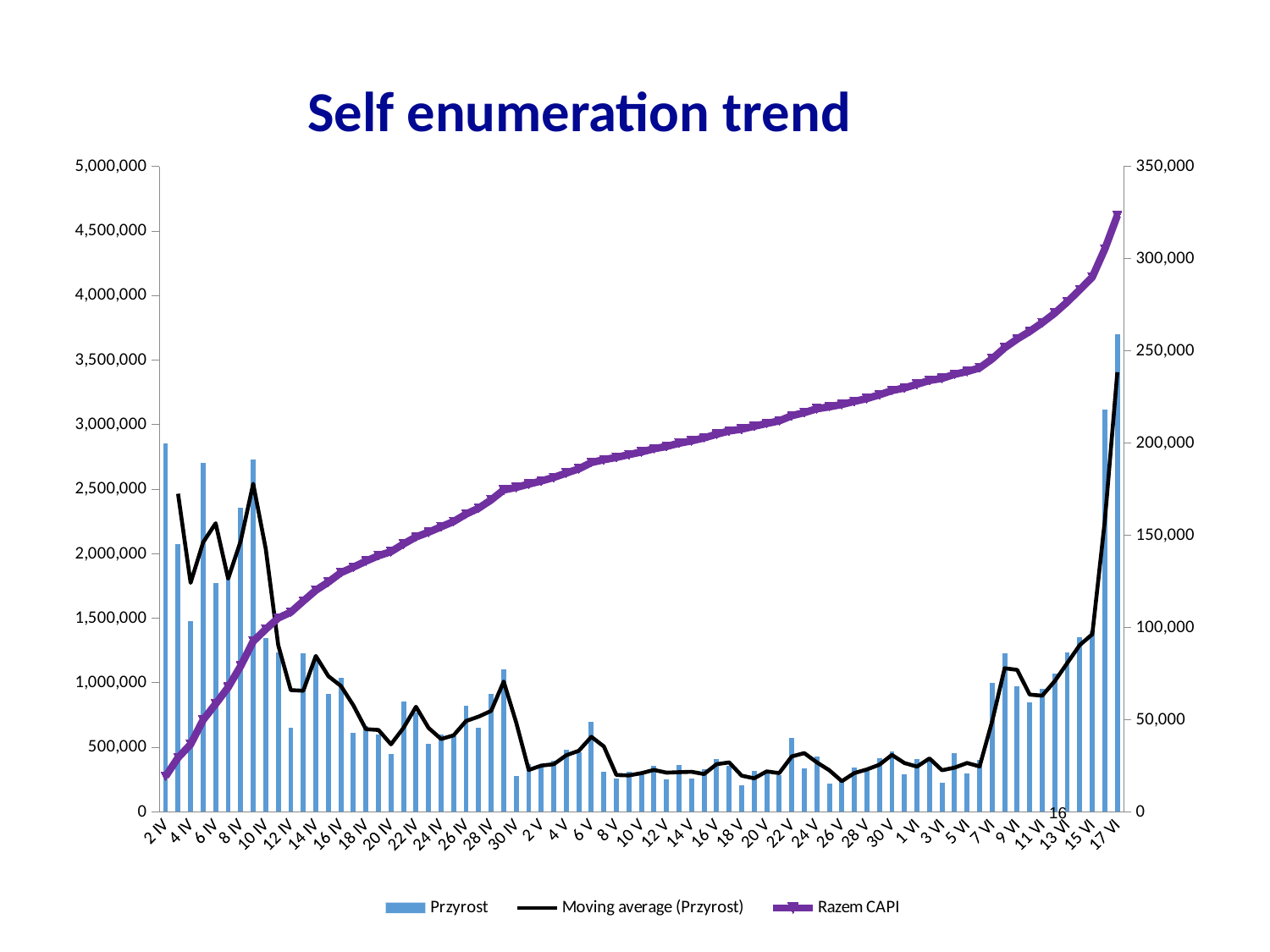
How many series does the legend list? 3 What is the title of the chart? Self enumeration trend What kind of chart is shown on the slide? A combined bar and line chart Does the Razem CAPI line rise or fall along the x axis? Rises Which Przyrost bar is taller, 2 IV or 17 VI? 17 VI Which Przyrost bar is taller, 4 IV or 6 IV? 6 IV Which series is drawn as bars according to the legend? Przyrost Which date has the highest Przyrost bar? 17 VI